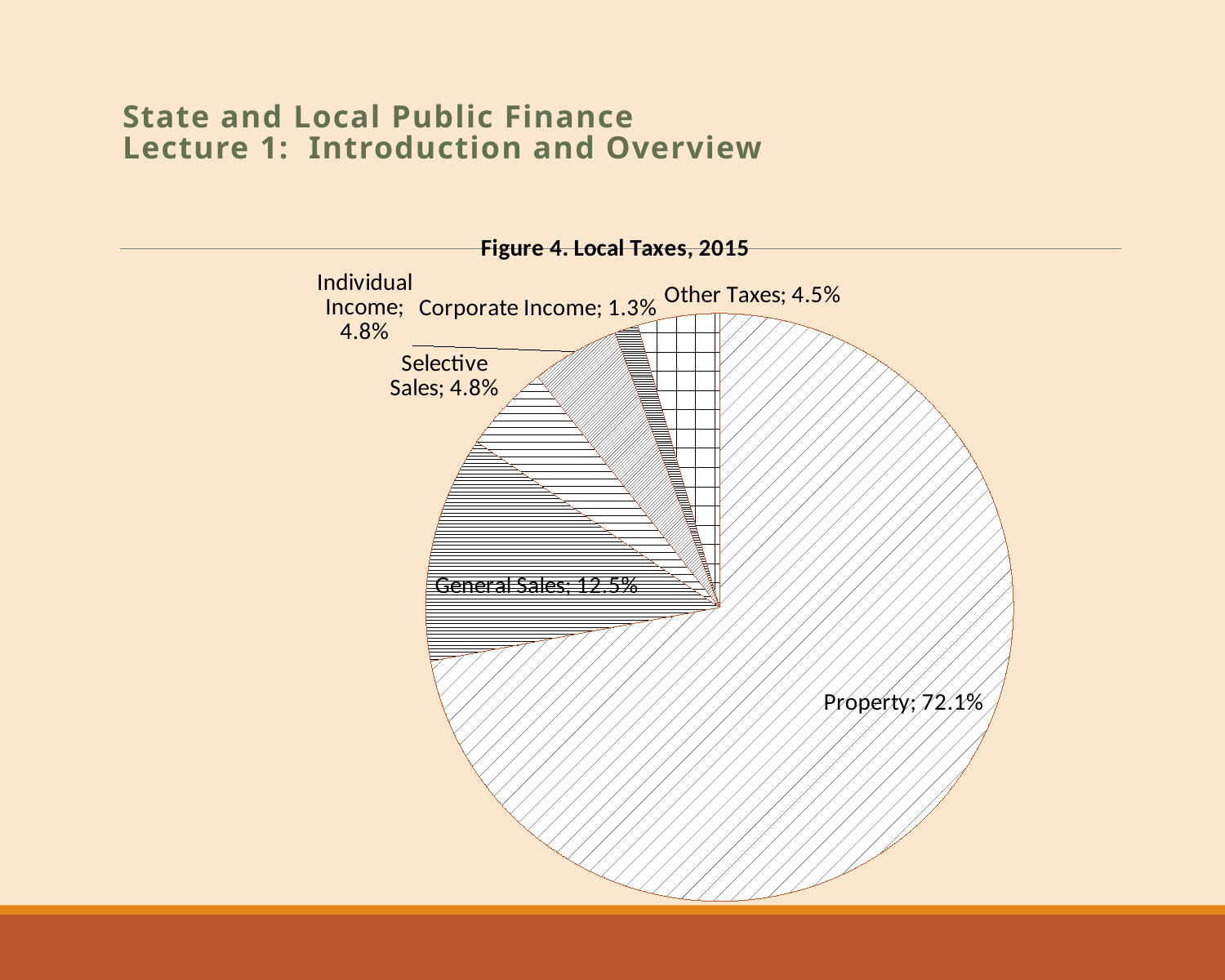
Which category has the largest share of the pie? Property What share of local taxes comes from Corporate Income? 1.3% How many categories are shown in the pie chart? 6 What share of local taxes comes from General Sales? 12.5% Which is larger, the share for General Sales or the share for Other Taxes? General Sales What is the difference between the Property share and the General Sales share? 59.6% What is the title of the chart? Figure 4. Local Taxes, 2015 What share of local taxes comes from Property? 72.1% What share of local taxes comes from Other Taxes? 4.5% What kind of chart is shown on the slide? pie chart What is the share for Selective Sales? 4.8% Which category has the smallest share of the pie? Corporate Income